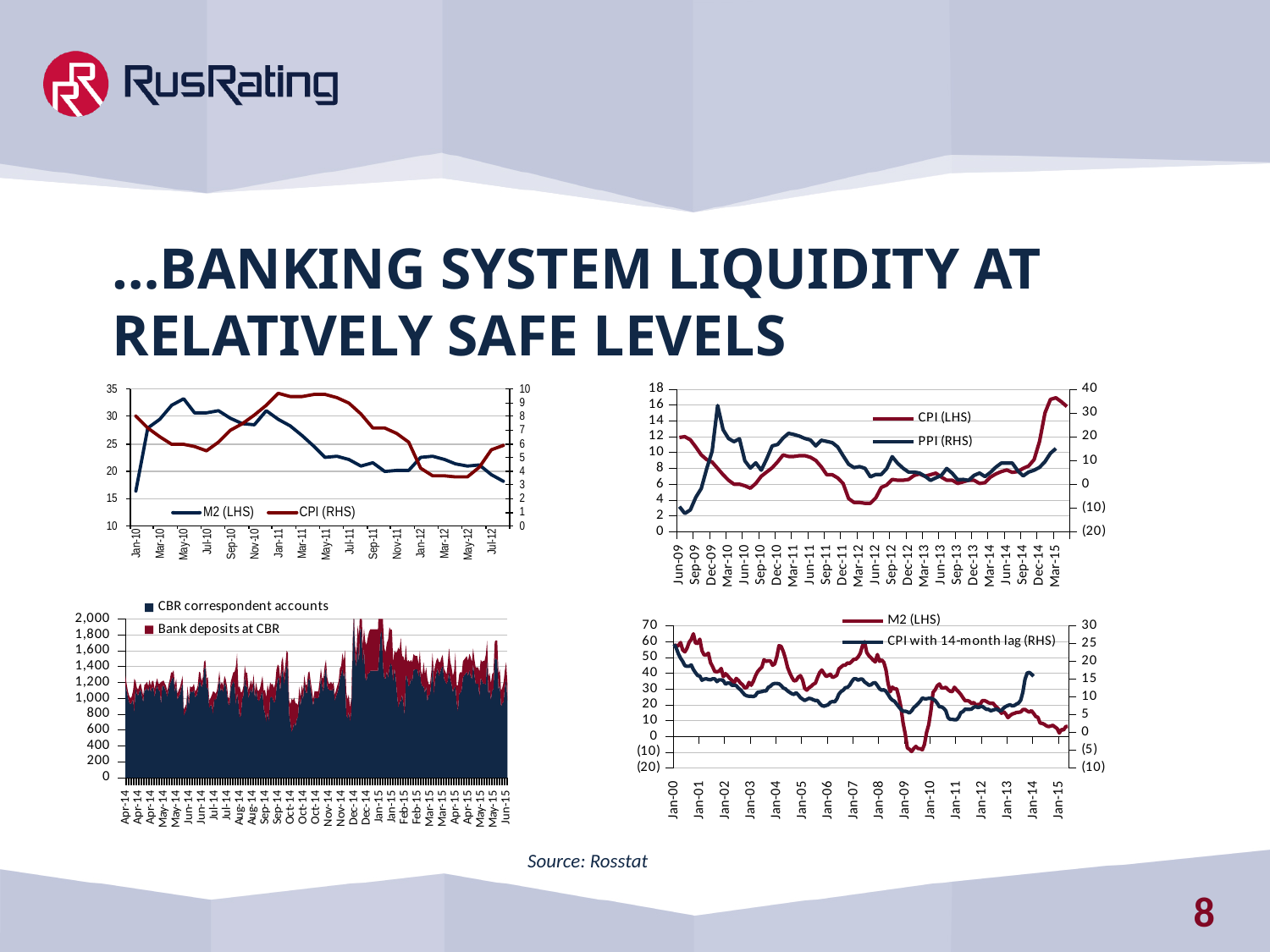
What kind of chart is the top-left chart on the slide? line chart What are the two series named in the legend of the bottom-right chart? M2 (LHS) and CPI with 14-month lag (RHS) In the top-right chart, does CPI (LHS) rise or fall between Dec-14 and Mar-15? rise How many series does the legend of the top-right chart list? 2 In the top-right chart, is the value of CPI (LHS) at Mar-15 greater or less than 14? greater What kind of chart is the bottom-left chart on the slide? stacked area chart In the bottom-right chart, does M2 (LHS) rise or fall between Jan-13 and Jan-15? fall In the top-right chart, is the peak value of PPI (RHS) around Dec-09 greater or less than 20? greater In the bottom-left chart, which series is shown in dark navy? CBR correspondent accounts In the top-left chart, is the value of M2 (LHS) at Jan-10 greater or less than 20? less